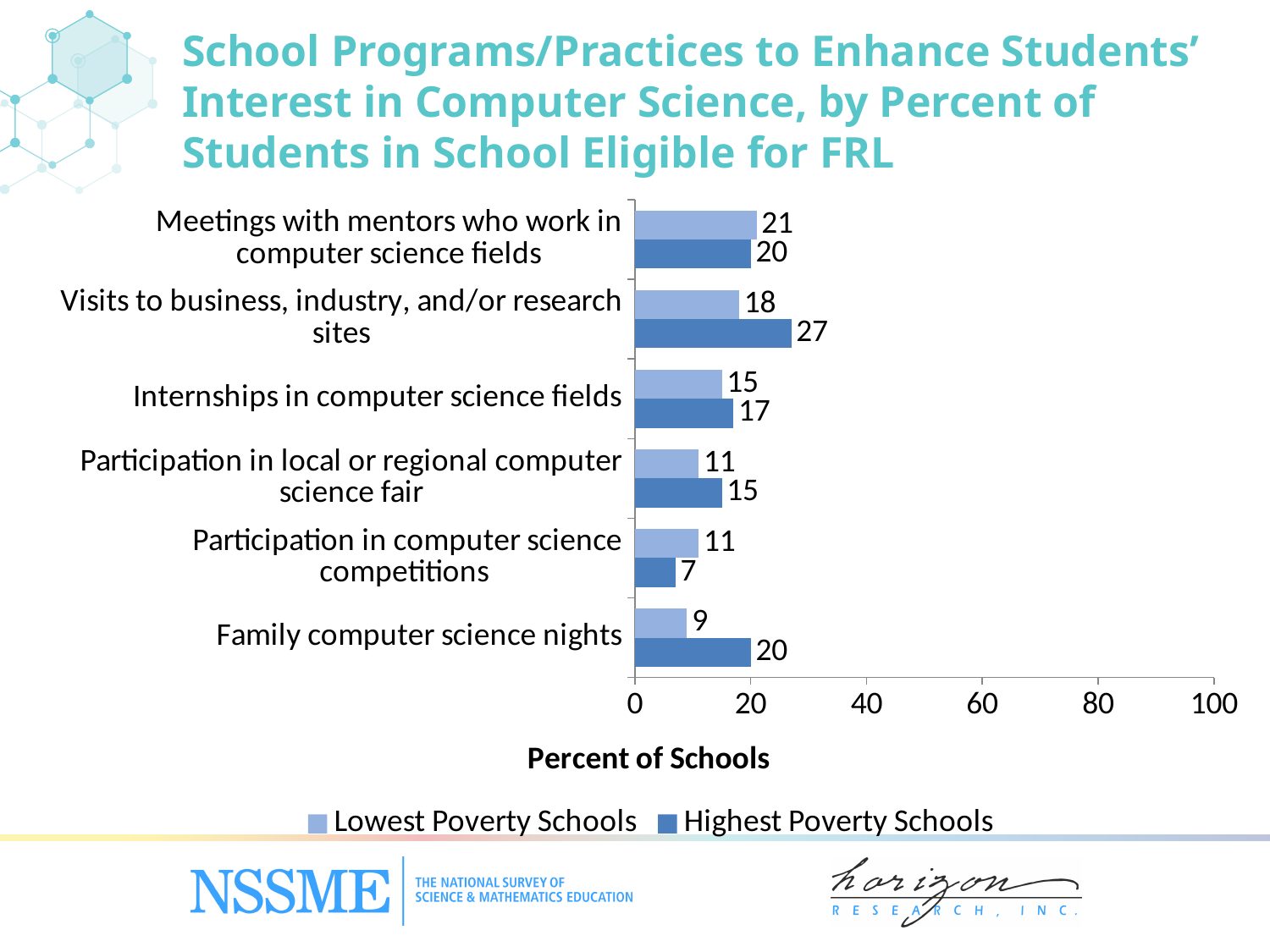
How many categories of school programs/practices are shown on the chart? 6 What percent of Highest Poverty Schools offer family computer science nights? 20 What is the label of the horizontal axis? Percent of Schools What kind of chart is shown on the slide? Bar chart What is the difference between Highest Poverty Schools and Lowest Poverty Schools for family computer science nights? 11 What percent of Lowest Poverty Schools offer meetings with mentors who work in computer science fields? 21 Which category has the lowest value for Lowest Poverty Schools? Family computer science nights Which category has the highest value for Highest Poverty Schools? Visits to business, industry, and/or research sites What percent of Highest Poverty Schools offer visits to business, industry, and/or research sites? 27 For participation in computer science competitions, which group has the larger value, Lowest Poverty Schools or Highest Poverty Schools? Lowest Poverty Schools How many series does the legend list? 2 Is the value for Highest Poverty Schools for visits to business, industry, and/or research sites greater or less than 20? greater